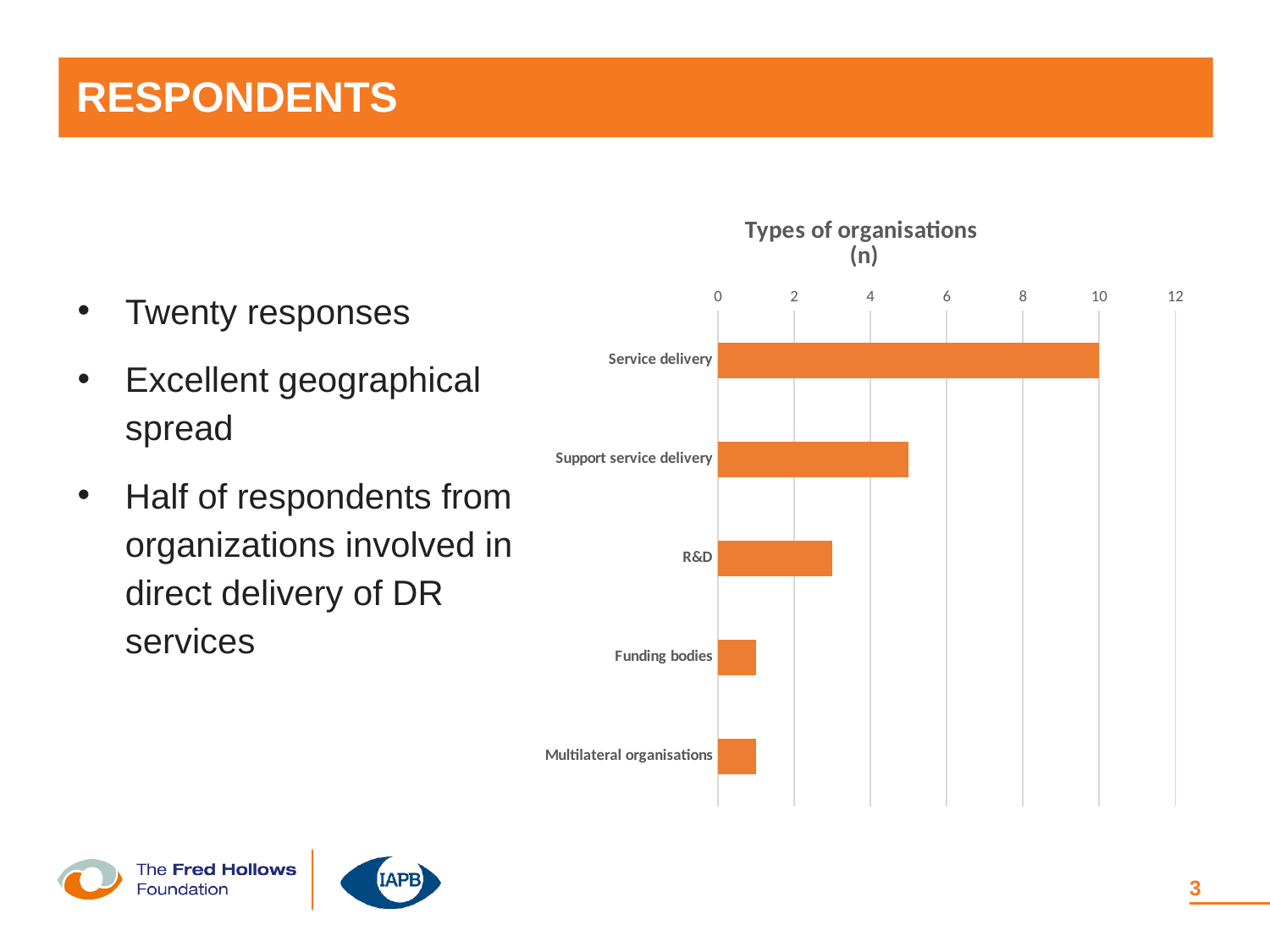
Which is larger, the value for Support service delivery or the value for R&D? Support service delivery Is the value for R&D greater or less than 2? greater What is the value for Service delivery in the Types of organisations chart? 10 Is the value for Support service delivery greater or less than 6? less How many types of organisations are shown in the chart? 5 Which type of organisation has the highest value in the chart? Service delivery Is the value for Funding bodies greater or less than 2? less What kind of chart is shown on the slide? Bar chart What is the title of the chart? Types of organisations (n)